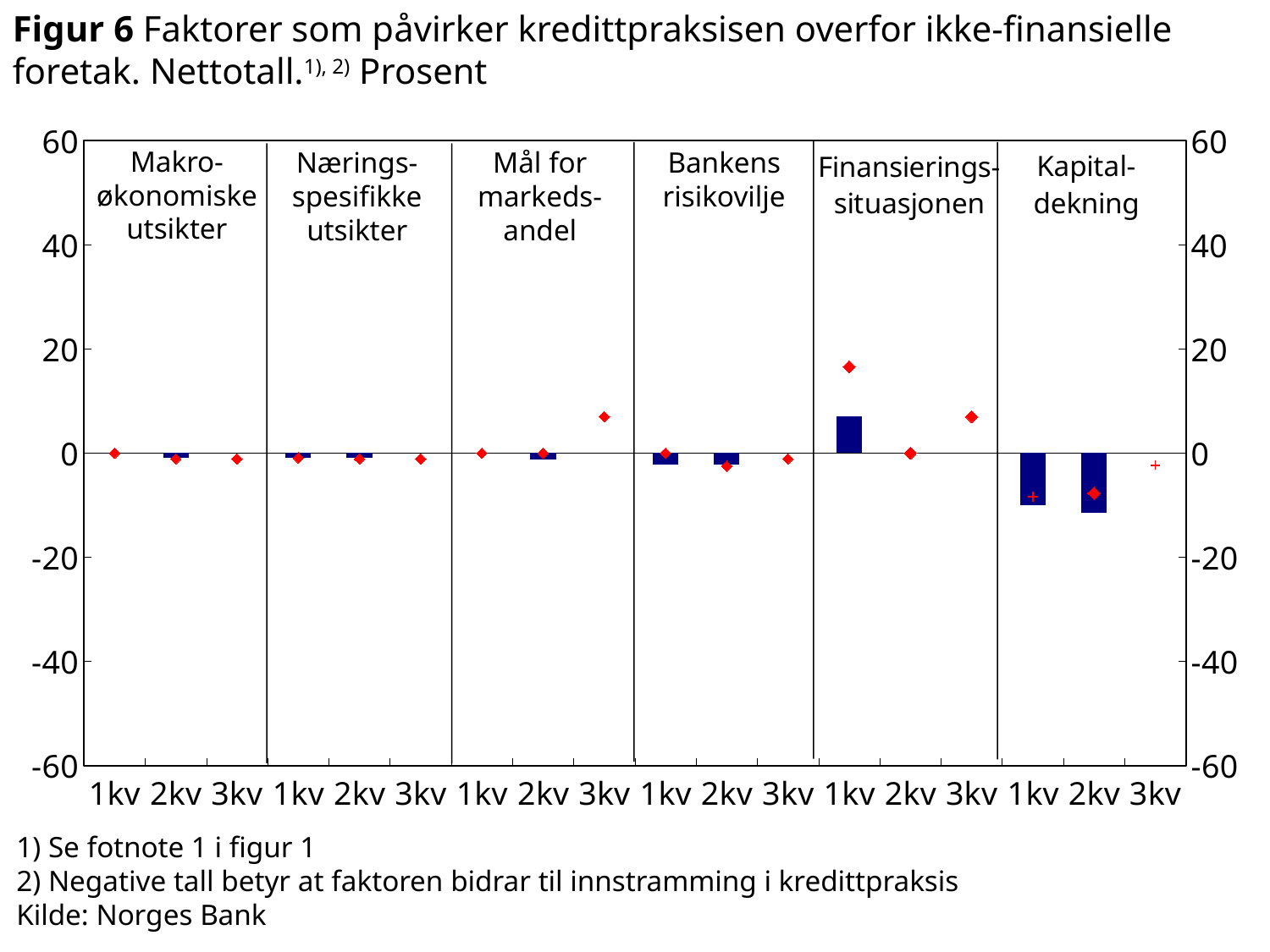
How many factors (panels) are shown along the x axis? 6 How many quarters (1kv, 2kv, 3kv) are shown for each factor? 3 Is the 1kv bar for Finansieringssituasjonen greater or less than 20? less Do the red markers for Mål for markedsandel rise or fall from 1kv to 3kv? rise What is the source given for the chart? Norges Bank Is the 1kv red marker for Finansieringssituasjonen greater or less than 10? greater Is the 2kv bar for Kapitaldekning greater or less than -20? greater Which factor has the lowest bar in the chart? Kapitaldekning What kind of chart is shown on the slide? bar chart Which factor has the highest bar in 1kv? Finansieringssituasjonen Which is larger, the 1kv bar for Finansieringssituasjonen or the 1kv bar for Kapitaldekning? Finansieringssituasjonen